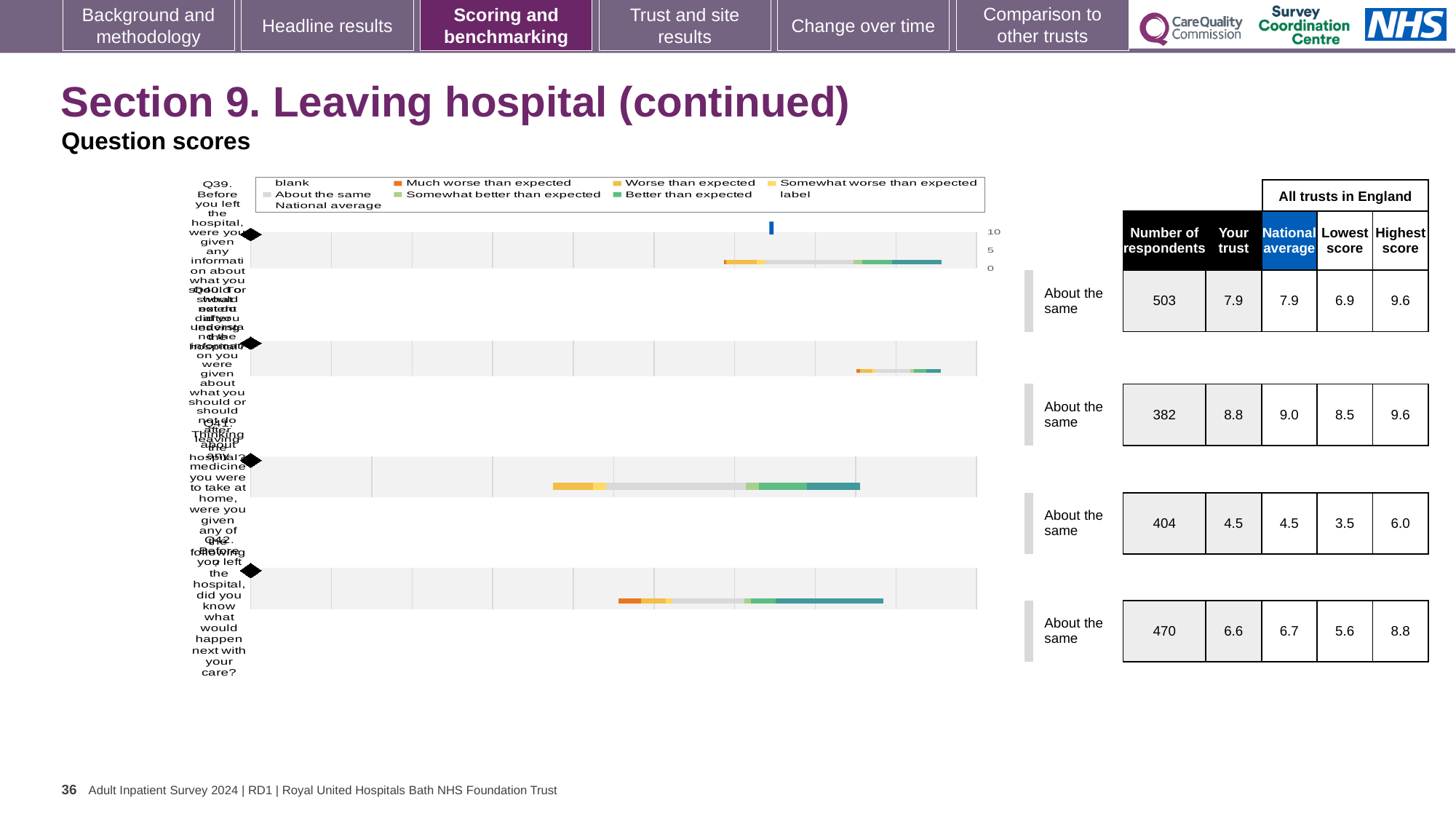
What is the highest score among all trusts in England for Q42 (Before you left the hospital, did you know what would happen next with your care)? 8.8 Which has the higher 'Your trust' score, Q39 or Q42? Q39 What kind of chart is shown on the slide? bar chart What is the number of respondents for Q42? 470 What is the 'Your trust' score for Q39? 7.9 What is the lowest score among all trusts in England for Q42? 5.6 What benchmark category is shown next to the chart for Q39? About the same In the chart legend, what colour represents 'Much worse than expected'? orange How many question rows (bars) are plotted in the chart? 4 What is the national average score for Q39? 7.9 What is the difference between the national average and the 'Your trust' score for Q42? 0.1 What is the number of respondents for Q39 (Before you left the hospital, were you given any information about what you should or should not do after leaving)? 503